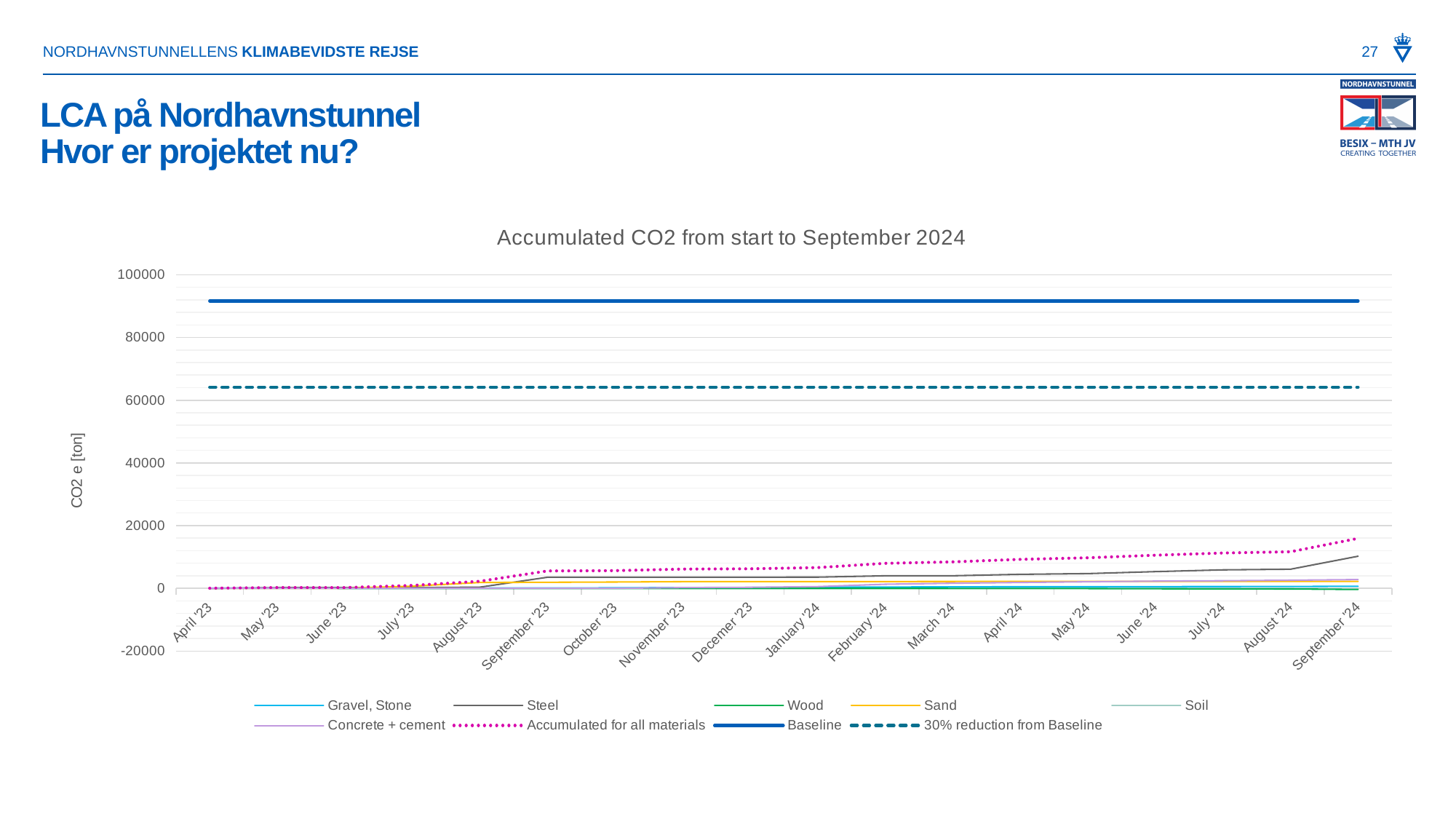
Is the value of the 30% reduction from Baseline line greater or less than 60000? greater How many series does the chart legend list? 9 How many months are shown along the x axis of the chart? 18 What kind of chart is shown on the slide? line chart Is the value of the Baseline line greater or less than 80000? greater Does the Accumulated for all materials line rise or fall from April '23 to September '24? rise In September '24, which is larger, Accumulated for all materials or Baseline? Baseline What is the label of the y axis? CO2 e [ton] What is the title of the chart? Accumulated CO2 from start to September 2024 Which series has the highest values on the chart? Baseline Is the value of Accumulated for all materials in September '24 greater or less than 20000? less Which is larger, the Baseline line or the 30% reduction from Baseline line? Baseline